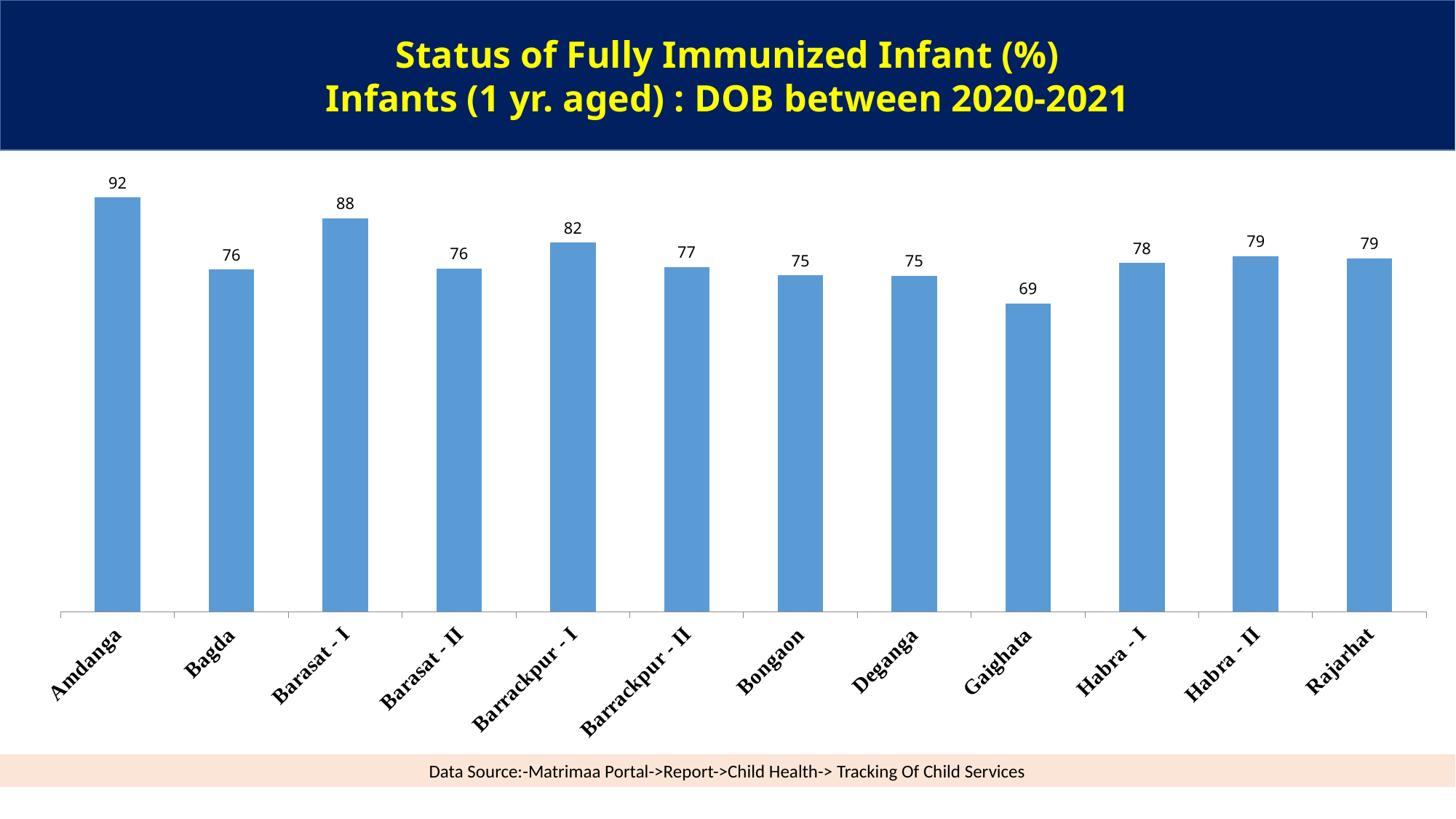
Which block has the highest value? Amdanga What is the difference between the values for Amdanga and Gaighata? 23 Which block has the lowest value? Gaighata What is the value for Amdanga? 92 What kind of chart is shown on the slide? Bar chart What is the value for Habra - II? 79 What is the difference between the values for Barasat - I and Barasat - II? 12 What data source is cited at the bottom of the slide? Matrimaa Portal->Report->Child Health-> Tracking Of Child Services How many blocks are shown on the chart? 12 Which is larger, the value for Barrackpur - I or the value for Barrackpur - II? Barrackpur - I What is the value for Barrackpur - I? 82 What is the value for Gaighata? 69